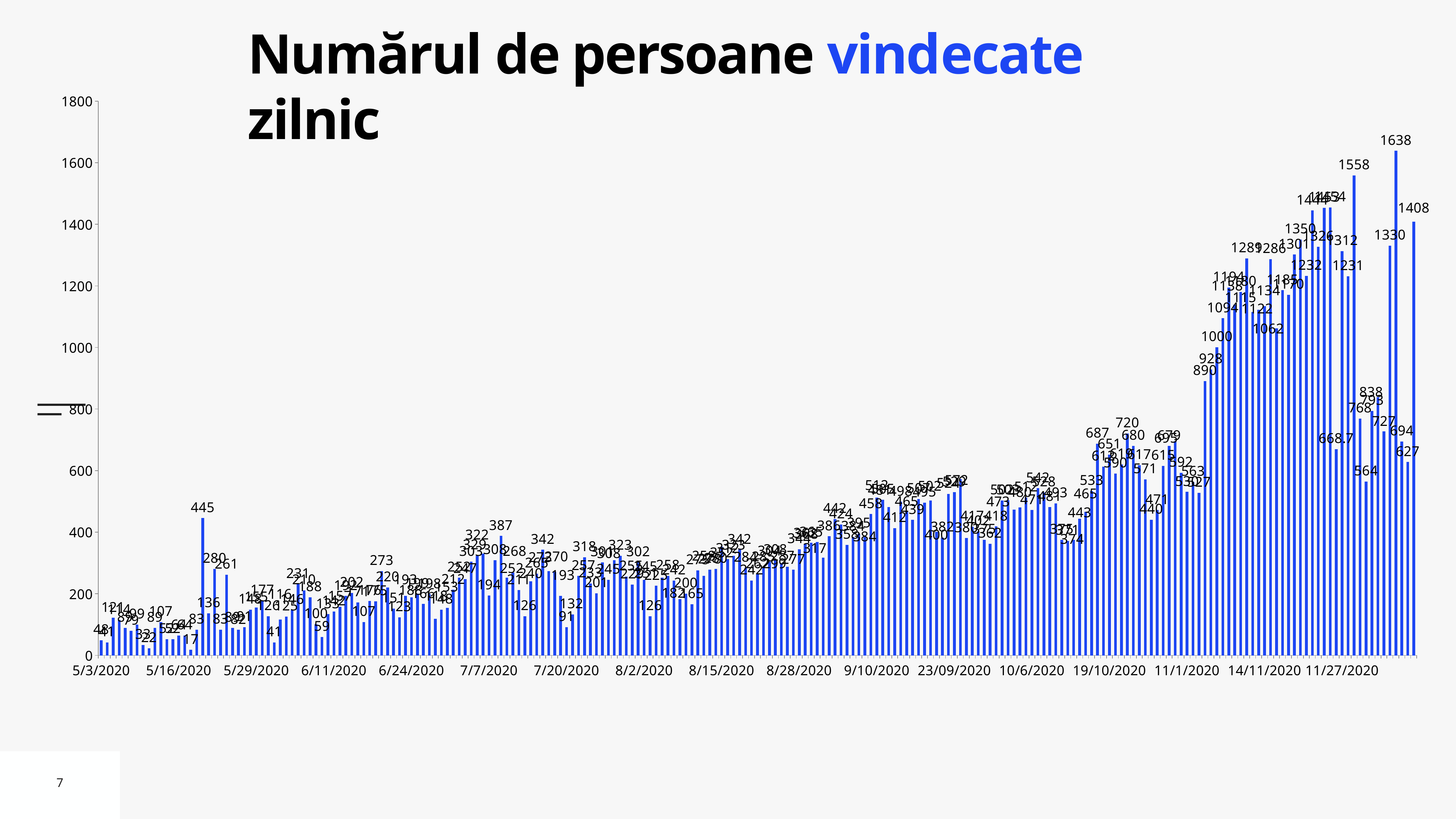
What is the value of the last bar on the right of the chart? 1408 What is the highest value shown in the chart? 1638 What is the lowest value labelled in the chart? 17 What is the title of the chart? Numărul de persoane vindecate zilnic What kind of chart is shown on the slide? bar chart Do the values generally rise or fall from left to right along the x axis? rise What colour are the bars in the chart? blue Is the value for 5/3/2020 greater or less than 200? less What is the value of the tallest bar between 7/7/2020 and 7/20/2020? 387 What is the difference between the highest value (1638) and the second highest value (1558)? 80 Which is larger: the highest bar (1638) or the last bar (1408)? 1638 What is the value of the tallest bar between 5/16/2020 and 5/29/2020? 445